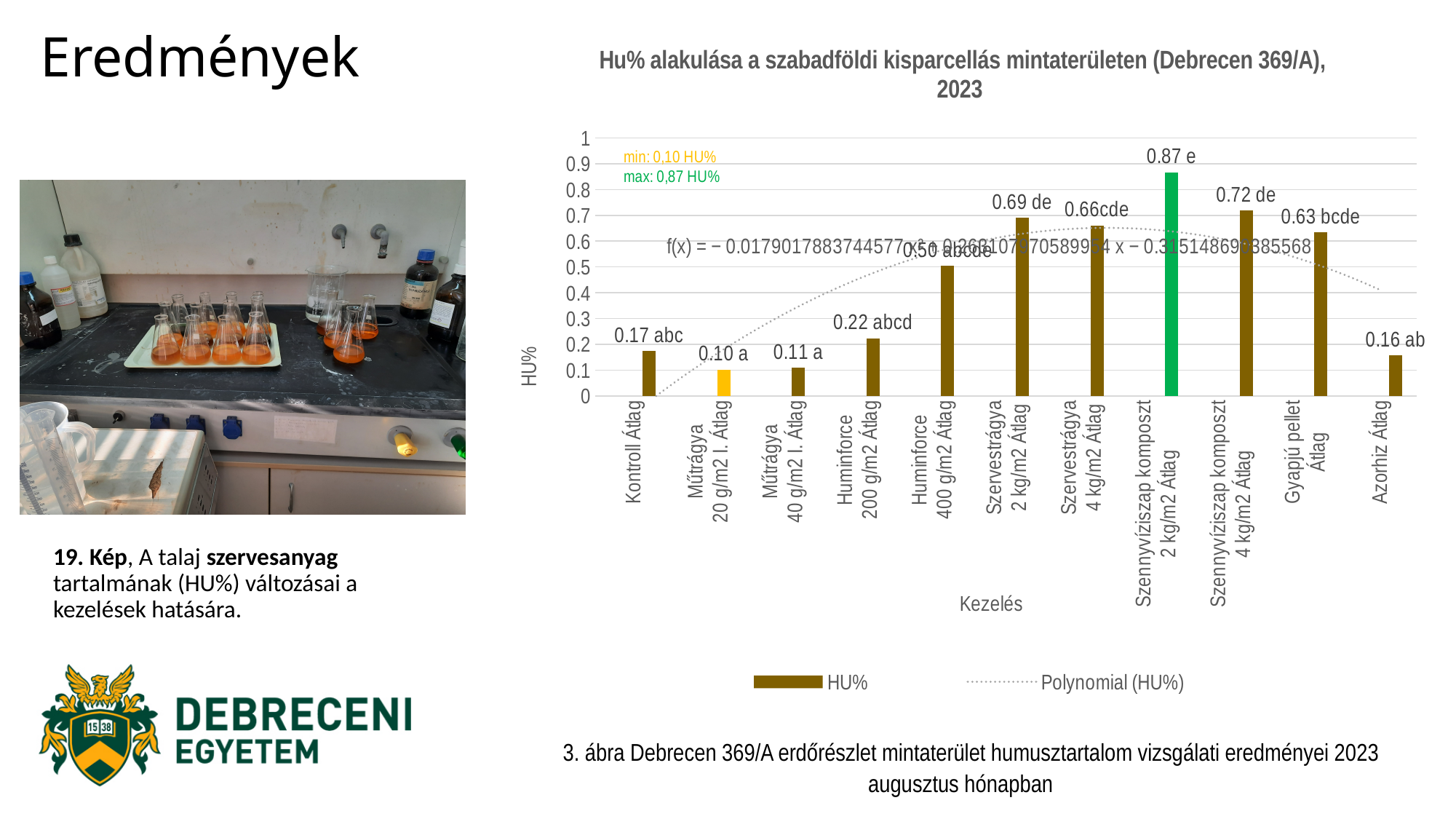
Is the HU% value for Huminforce 400 g/m2 Átlag greater or less than 0.4? greater What is the HU% value for Gyapjú pellet Átlag? 0.63 What type of chart is shown on the slide? bar chart How many entries does the legend list? 2 What is the difference in HU% between Szennyvíziszap komposzt 2 kg/m2 Átlag and Szennyvíziszap komposzt 4 kg/m2 Átlag? 0.15 Which has a higher HU% value, Szervestrágya 2 kg/m2 Átlag or Szervestrágya 4 kg/m2 Átlag? Szervestrágya 2 kg/m2 Átlag Which treatment has the highest HU% value? Szennyvíziszap komposzt 2 kg/m2 Átlag How many treatment categories are shown on the x axis? 11 Which treatment has the lowest HU% value? Műtrágya 20 g/m2 I. Átlag What is the HU% value for Kontroll Átlag? 0.17 What is the HU% value for Szennyvíziszap komposzt 2 kg/m2 Átlag? 0.87 What is the label of the y axis? HU%